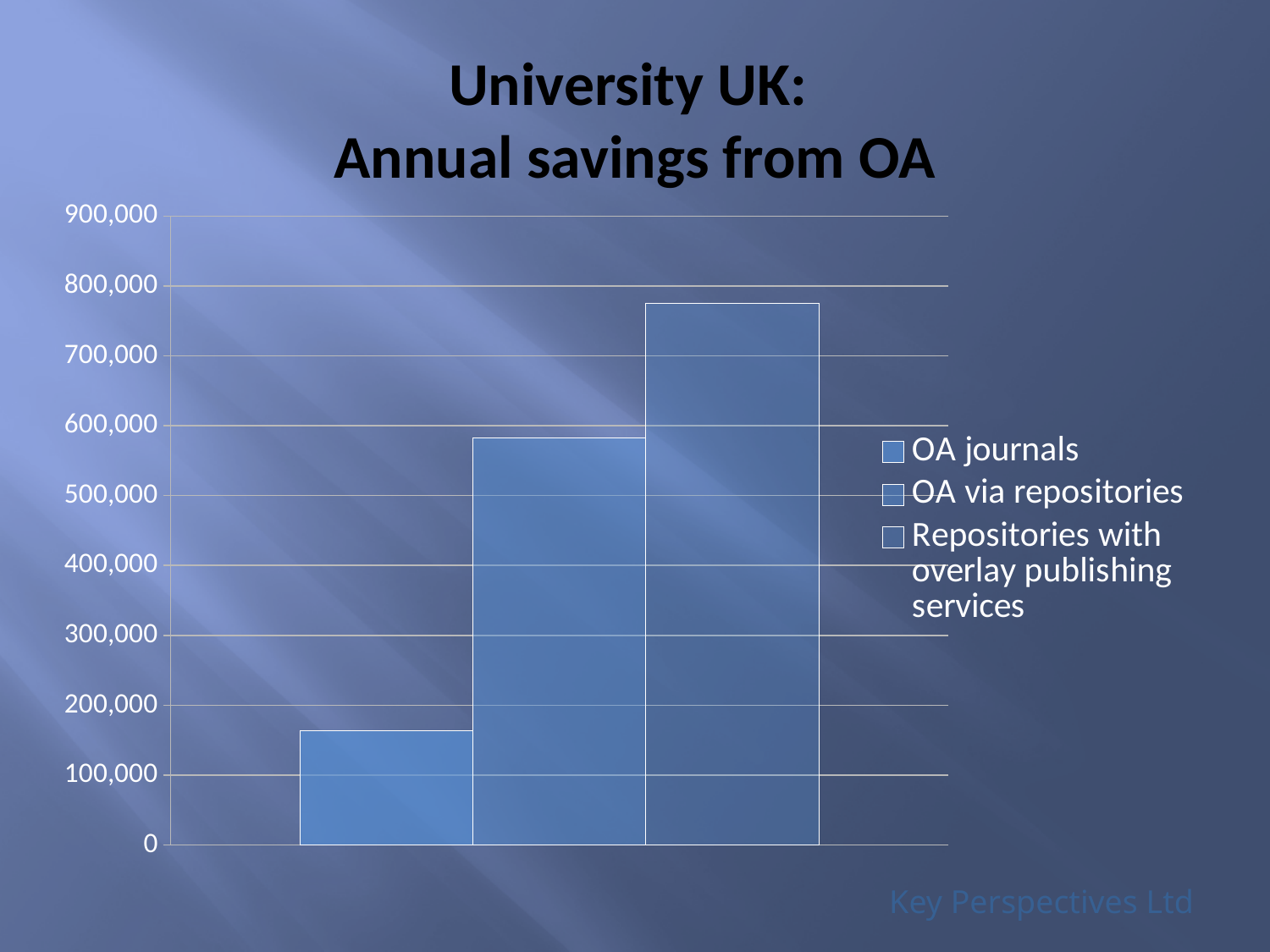
Is the value for OA journals greater or less than 200,000? less Which is larger, the value for OA journals or the value for OA via repositories? OA via repositories What kind of chart is shown on the slide? bar chart How many bars are plotted in the chart? 3 Is the value for OA journals greater or less than 100,000? greater Which series has the lowest annual savings? OA journals Which series has the highest annual savings? Repositories with overlay publishing services Is the value for Repositories with overlay publishing services greater or less than 700,000? greater How many series does the legend list? 3 Do the bar values rise or fall from left to right across the chart? rise What is the title of the chart? University UK: Annual savings from OA